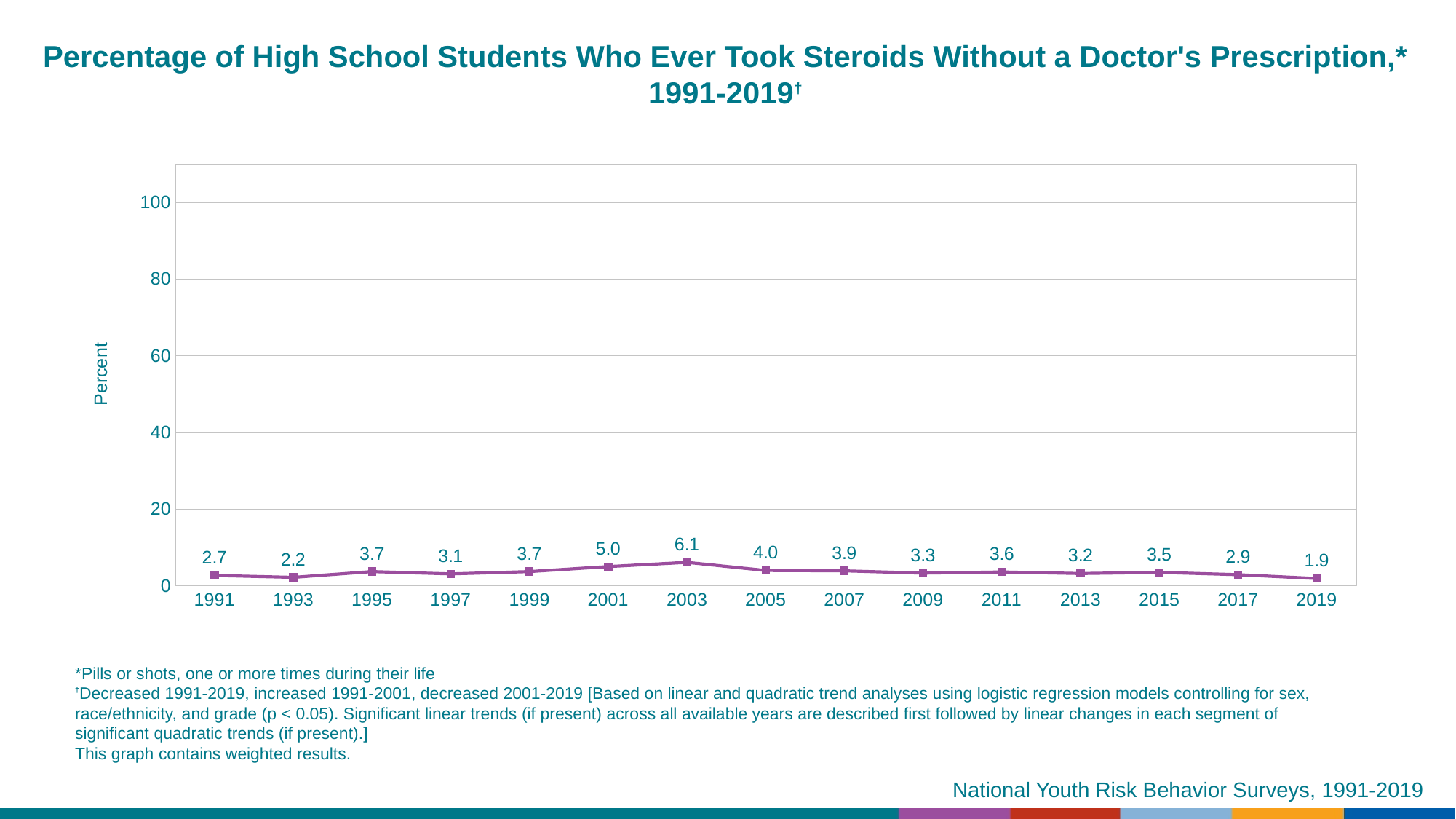
How many years are plotted on the x axis? 15 What is the label on the y axis? Percent What is the value plotted for 2019? 1.9 What is the value plotted for 1991? 2.7 Which year has a higher value, 2001 or 2011? 2001 What is the difference between the 2003 value and the 2019 value? 4.2 Which year has the lowest percentage on the chart? 2019 Which year has the highest percentage on the chart? 2003 Do the values rise or fall from 2003 to 2019? Fall What kind of chart is shown on the slide? Line chart Is the value for 2003 greater or less than 20? less What percentage of high school students reported ever taking steroids without a doctor's prescription in 2003? 6.1